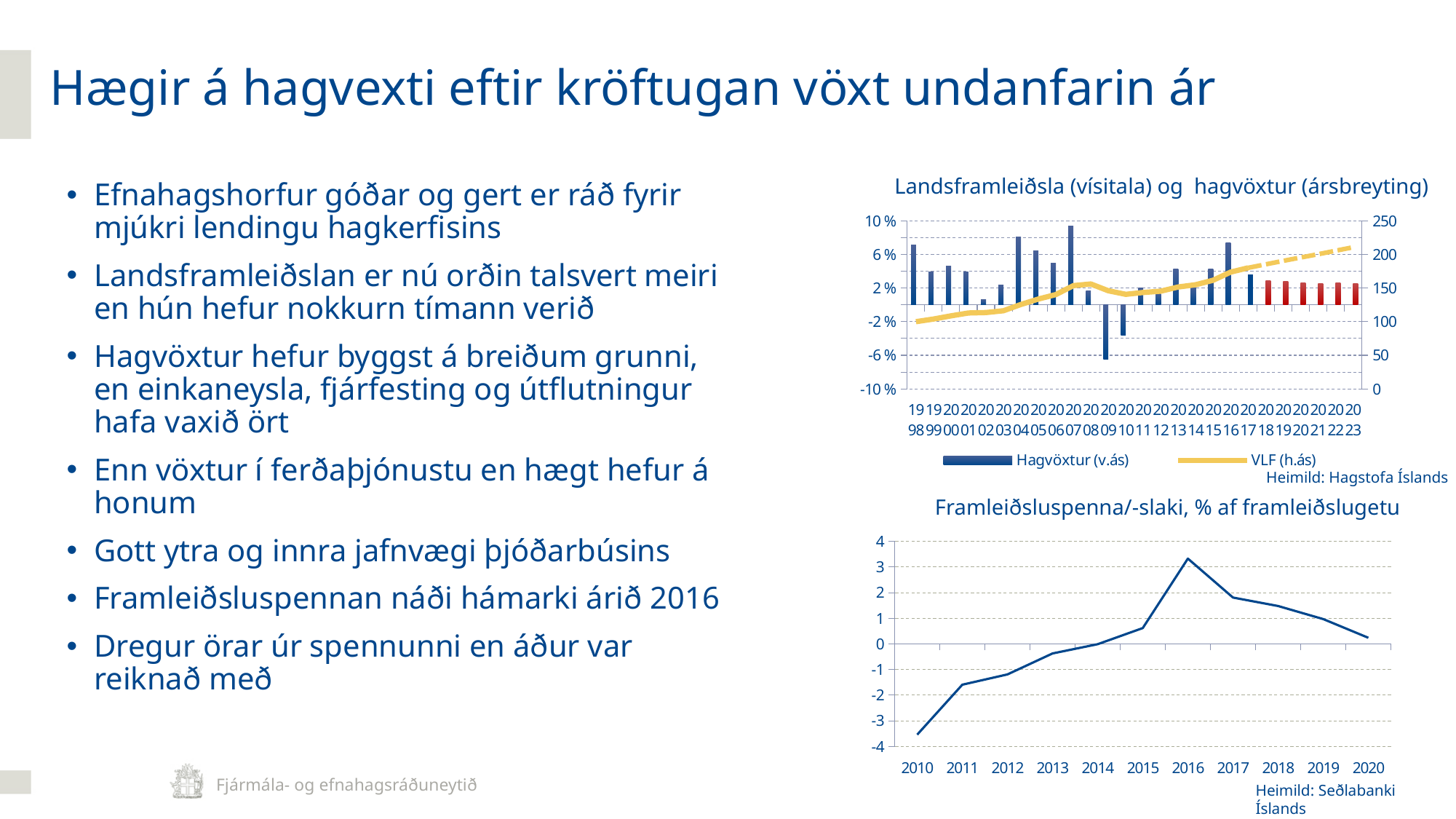
In the chart titled "Landsframleiðsla (vísitala) og hagvöxtur (ársbreyting)", is the Hagvöxtur value for 2007 greater or less than 6 %? greater In the chart titled "Landsframleiðsla (vísitala) og hagvöxtur (ársbreyting)", how many series does the legend list? 2 In the chart titled "Framleiðsluspenna/-slaki, % af framleiðslugetu", which year has the lowest value? 2010 In the chart titled "Landsframleiðsla (vísitala) og hagvöxtur (ársbreyting)", what are the two legend entries? Hagvöxtur (v.ás) and VLF (h.ás) In the chart titled "Landsframleiðsla (vísitala) og hagvöxtur (ársbreyting)", which year has the highest Hagvöxtur bar? 2007 In the chart titled "Framleiðsluspenna/-slaki, % af framleiðslugetu", which year has the highest value? 2016 In the chart titled "Framleiðsluspenna/-slaki, % af framleiðslugetu", is the value for 2010 greater or less than -3? less In the chart titled "Landsframleiðsla (vísitala) og hagvöxtur (ársbreyting)", which year has the lowest Hagvöxtur bar? 2009 In the chart titled "Framleiðsluspenna/-slaki, % af framleiðslugetu", how many years are shown on the x axis? 11 In the chart titled "Framleiðsluspenna/-slaki, % af framleiðslugetu", do the values rise or fall from 2016 to 2020? fall What kind of chart is the one titled "Framleiðsluspenna/-slaki, % af framleiðslugetu"? line chart In the chart titled "Landsframleiðsla (vísitala) og hagvöxtur (ársbreyting)", is the Hagvöxtur value for 2009 greater or less than -2 %? less